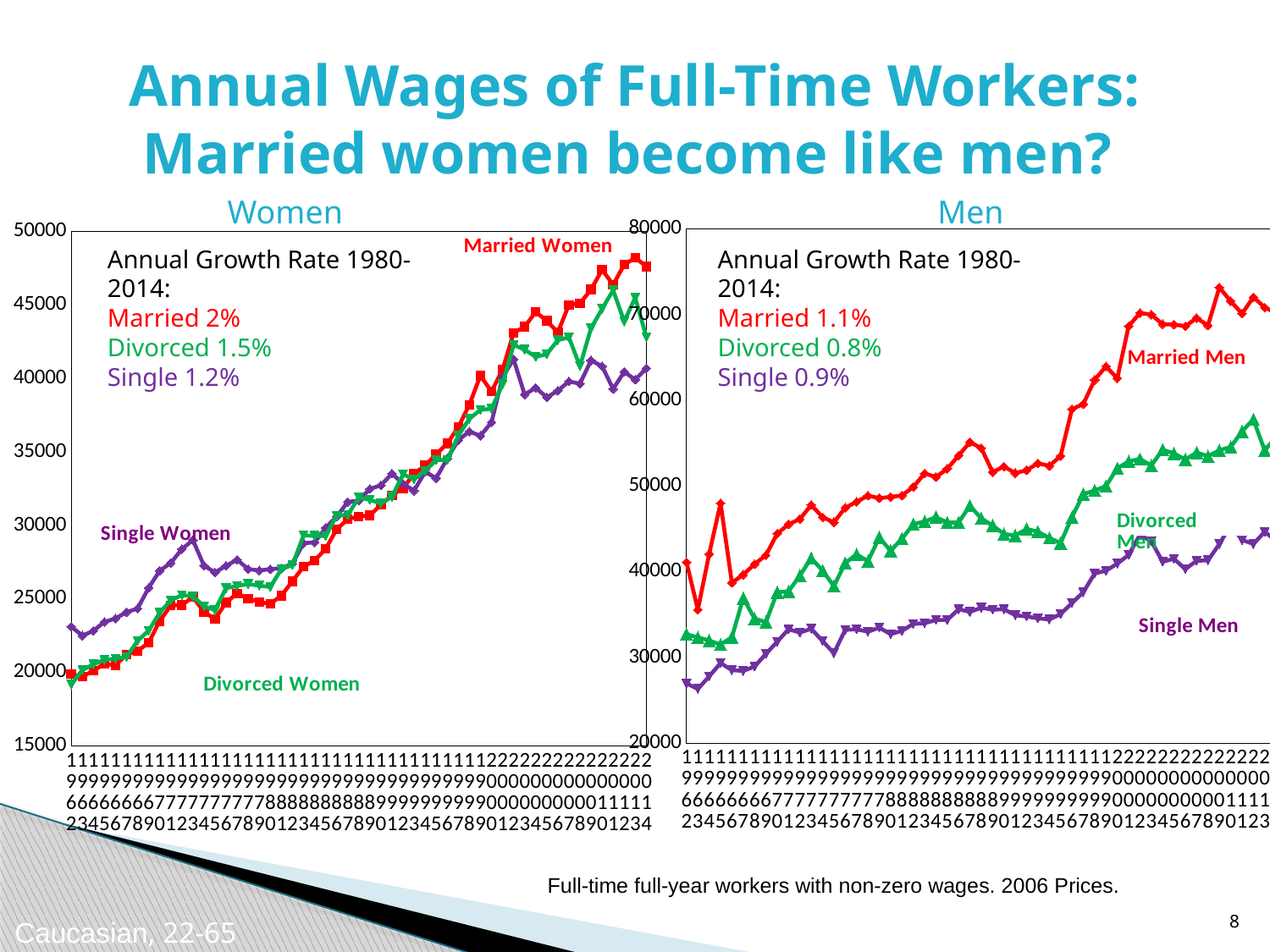
According to the Men chart, what is the annual growth rate 1980-2014 for divorced men? 0.8% On the Men chart, which series has the highest wages at the end of the period? Married Men According to the Women chart, what is the annual growth rate 1980-2014 for married women? 2% On the Women chart, at the start of the period (early 1960s), which is higher: Single Women or Divorced Women? Single Women On the Men chart, is the value for Married Men at the end of the period (2014) greater or less than 60000? greater On the Women chart, is the value for Married Women at the end of the period (2014) greater or less than 45000? greater On the Women chart, is the value for Single Women at the end of the period (2014) greater or less than 35000? greater How many series are plotted on the Men chart? 3 On the Men chart, which series has the lowest wages at the end of the period? Single Men What kind of chart is the Women chart? line chart On the Women chart, do the wages of Married Women rise or fall over the period shown? rise